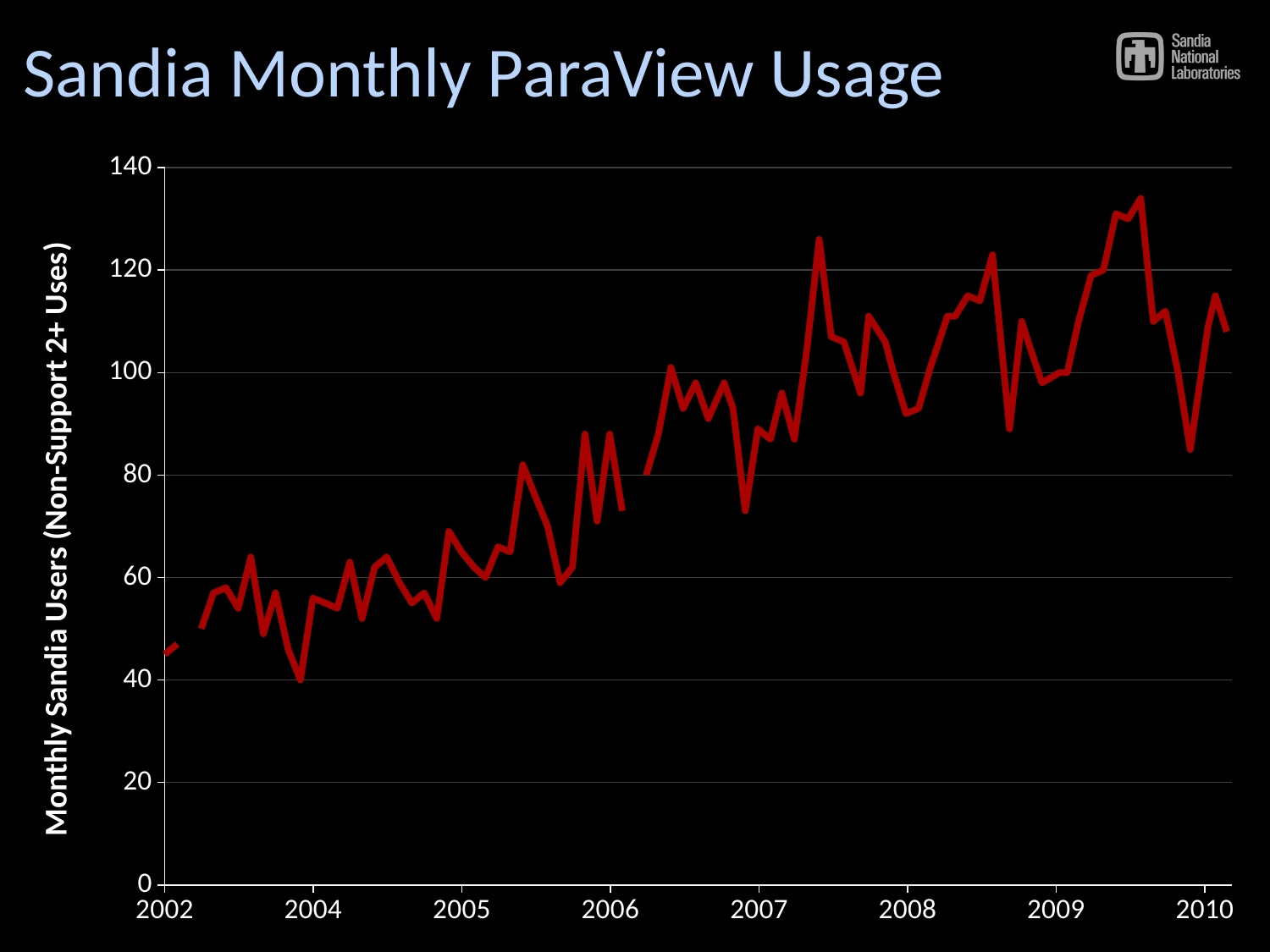
Is the lowest value on the chart, in late 2003, greater or less than 60? less Is the highest value on the chart, reached in 2009, greater or less than 120? greater Is the peak value in 2007 greater or less than 100? greater What is the label on the vertical axis of the chart? Monthly Sandia Users (Non-Support 2+ Uses) What kind of chart is shown on the slide? line chart Is the value at the start of 2002 larger or smaller than the value at the start of 2010? smaller What is the title of the chart on the slide? Sandia Monthly ParaView Usage Overall, do the values rise or fall from 2002 to 2010? rise In which year does the line reach its lowest point? 2003 In which year does the line reach its highest point? 2009